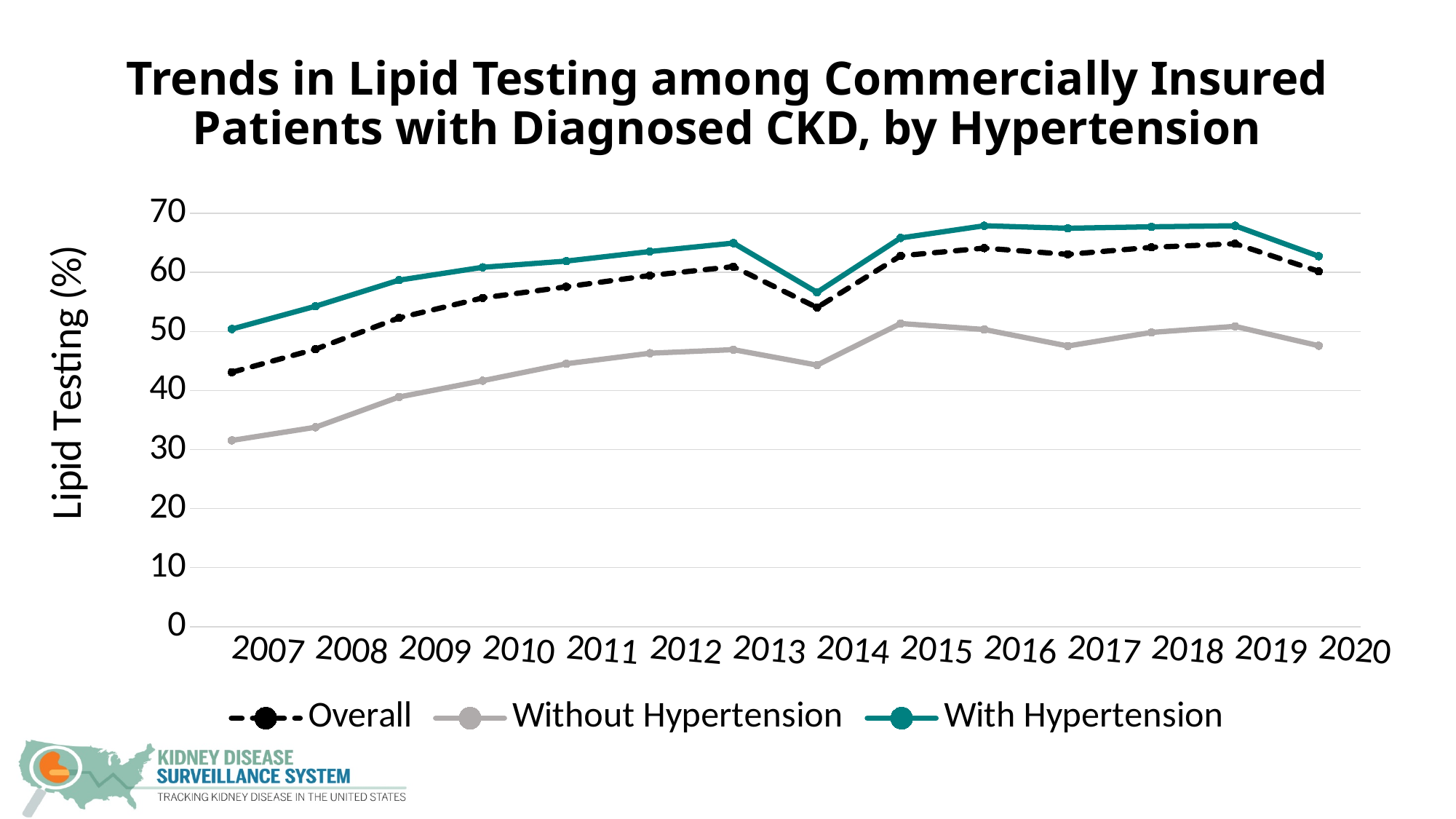
Is the value for Without Hypertension in 2020 greater or less than 50? less From 2007 to 2012, does the Overall series rise or fall? rise What kind of chart is shown on the slide? line chart In 2014, which series has the higher value, With Hypertension or Without Hypertension? With Hypertension Is the value for Without Hypertension in 2007 greater or less than 40? less What is the label on the y axis? Lipid Testing (%) Which series has the highest values across all years? With Hypertension How many years are plotted along the x axis? 14 Is the value for Overall in 2016 greater or less than 60? greater In which year does the Without Hypertension series have its lowest value? 2007 How many series does the legend list? 3